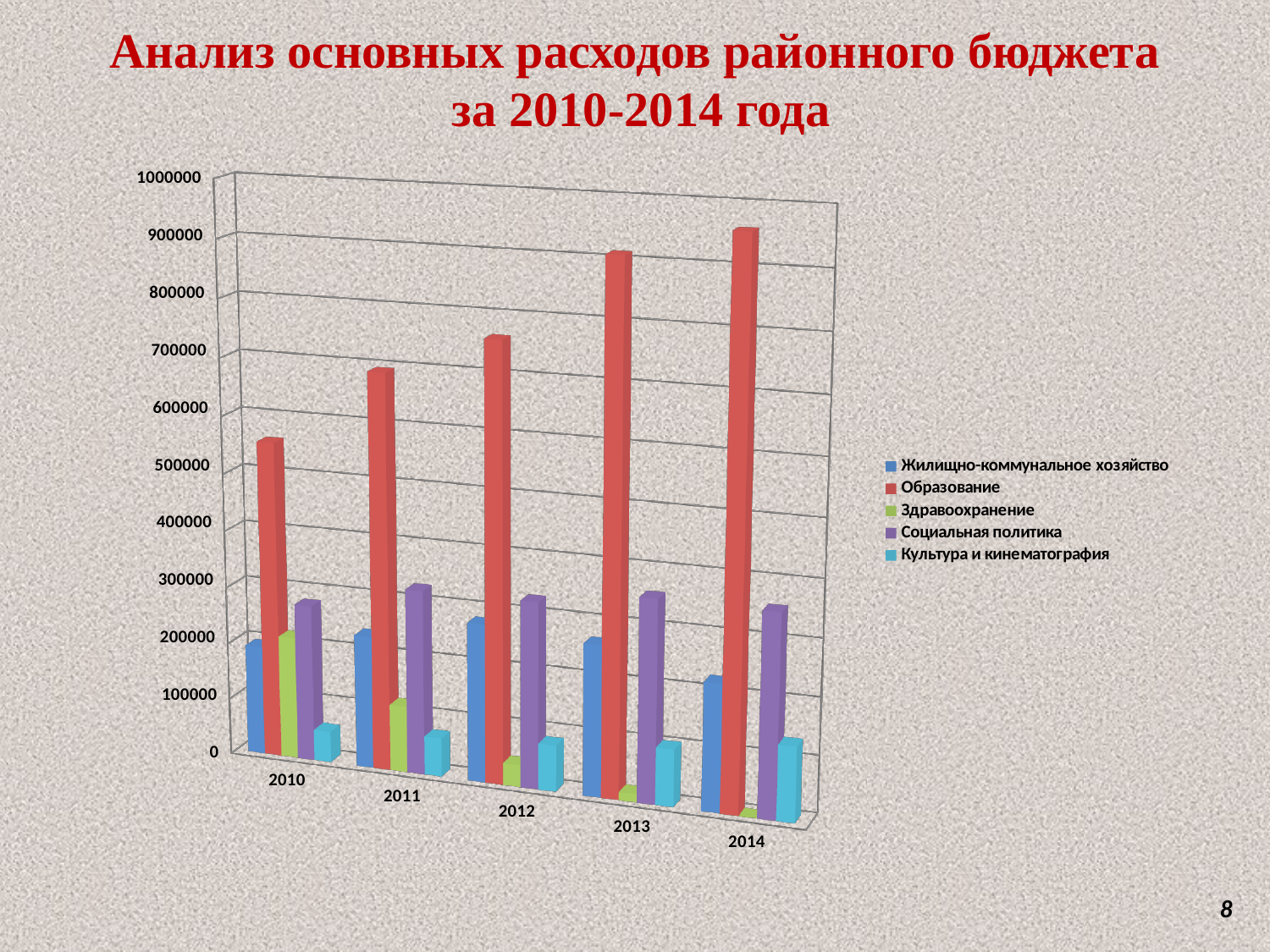
Is the value for Образование in 2014 greater or less than 800000? greater Do the values for Образование rise or fall from 2010 to 2014? rise How many series does the chart legend list? 5 How many years are shown on the x axis of the chart? 5 Is the value for Здравоохранение in 2011 greater or less than 200000? less In which year is the value for Здравоохранение the highest? 2010 In 2014, which is larger: Жилищно-коммунальное хозяйство or Социальная политика? Социальная политика In which year is the value for Образование the lowest? 2010 In which year is the value for Образование the highest? 2014 Which series has the tallest bars in every year of the chart? Образование Do the values for Здравоохранение rise or fall from 2010 to 2014? fall What kind of chart is shown on the slide? bar chart